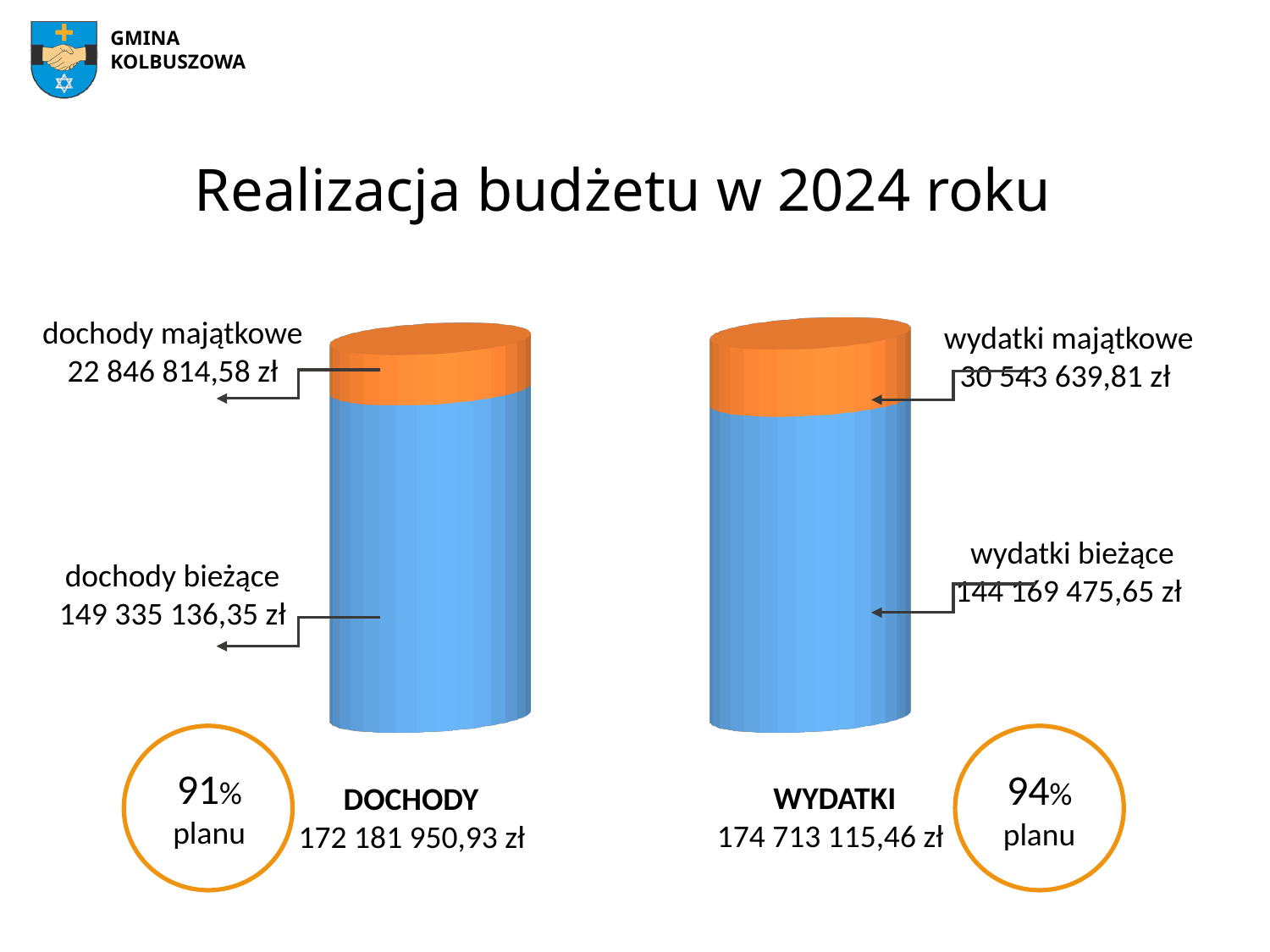
In the WYDATKI chart, what is the value of wydatki bieżące? 144 169 475,65 zł What is the total shown for the WYDATKI chart? 174 713 115,46 zł In the DOCHODY chart, what is the value of dochody majątkowe? 22 846 814,58 zł What is the total shown for the DOCHODY chart? 172 181 950,93 zł Which is larger, wydatki majątkowe in the WYDATKI chart or dochody majątkowe in the DOCHODY chart? wydatki majątkowe What percentage of the plan was realised for DOCHODY? 91% In the WYDATKI chart, what is the difference between wydatki bieżące and wydatki majątkowe? 113 625 835,84 zł In the DOCHODY chart, what is the value of dochody bieżące? 149 335 136,35 zł In the WYDATKI chart, what is the value of wydatki majątkowe? 30 543 639,81 zł In the DOCHODY chart, what is the difference between dochody bieżące and dochody majątkowe? 126 488 321,77 zł In the DOCHODY chart, which segment is larger, dochody bieżące or dochody majątkowe? dochody bieżące What colour is the dochody majątkowe segment in the DOCHODY chart? orange